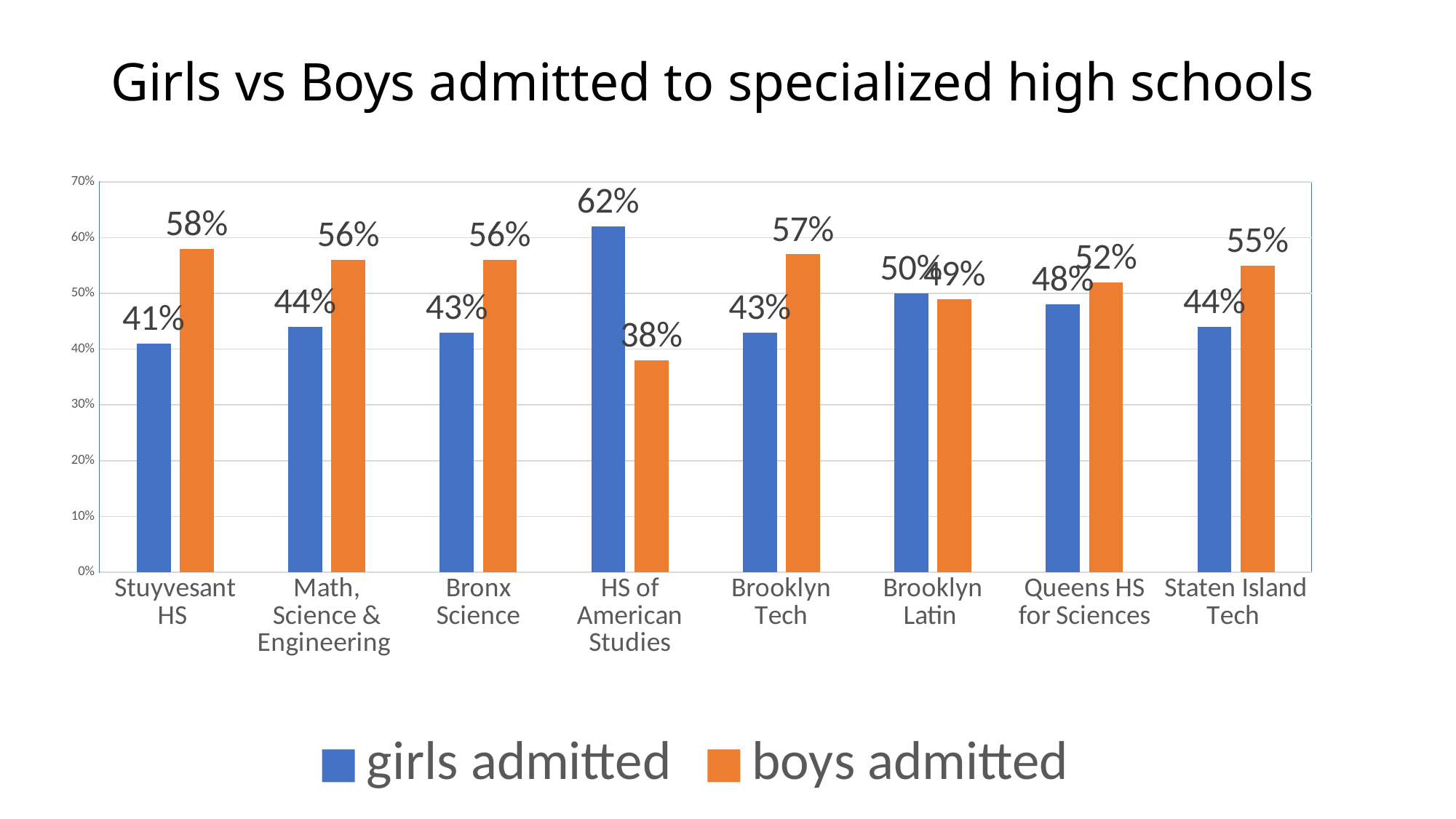
How many schools are shown on the chart? 8 What percentage of boys were admitted to Brooklyn Tech? 57% At Brooklyn Latin, which is larger: the percentage of girls admitted or boys admitted? girls admitted What type of chart is shown on the slide? bar chart Which school has the highest percentage of girls admitted? HS of American Studies Is the percentage of girls admitted to Bronx Science greater or less than 50%? less What is the difference between the boys admitted and girls admitted percentages at Stuyvesant HS? 17% What is the title of the chart? Girls vs Boys admitted to specialized high schools What percentage of girls were admitted to Stuyvesant HS? 41% What percentage of boys were admitted to HS of American Studies? 38% How many series does the legend list? 2 Which school has the lowest percentage of boys admitted? HS of American Studies